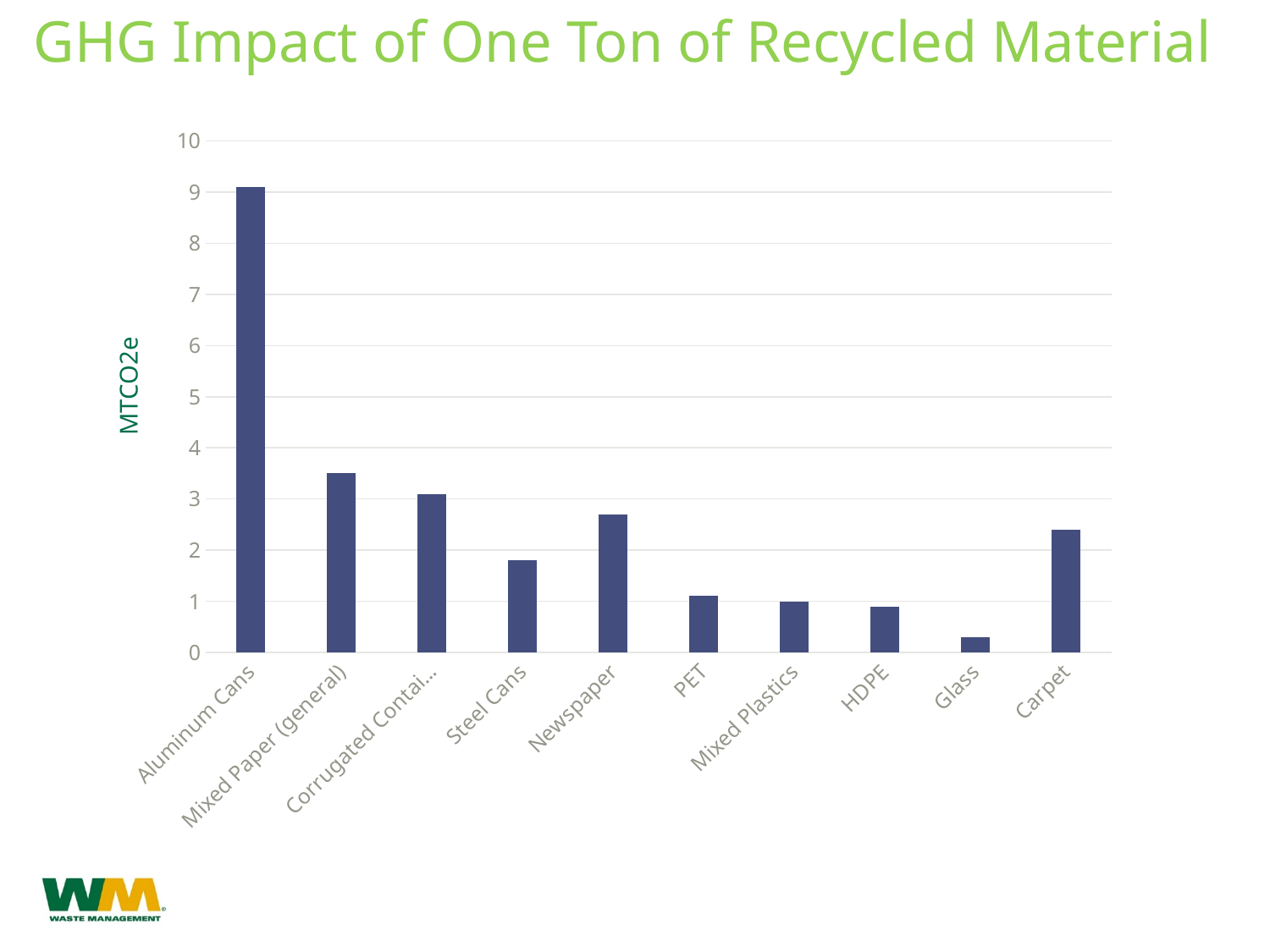
What is the label on the y axis? MTCO2e Is the value for Mixed Paper (general) greater or less than 3? greater Is the value for Carpet greater or less than 2? greater How many materials are shown on the x axis? 10 Which has a larger value, Newspaper or Steel Cans? Newspaper Which has a larger value, Carpet or HDPE? Carpet Is the value for Glass greater or less than 1? less Which material has the lowest GHG impact per ton recycled? Glass Which material has the highest GHG impact per ton recycled? Aluminum Cans What kind of chart is shown on the slide? bar chart